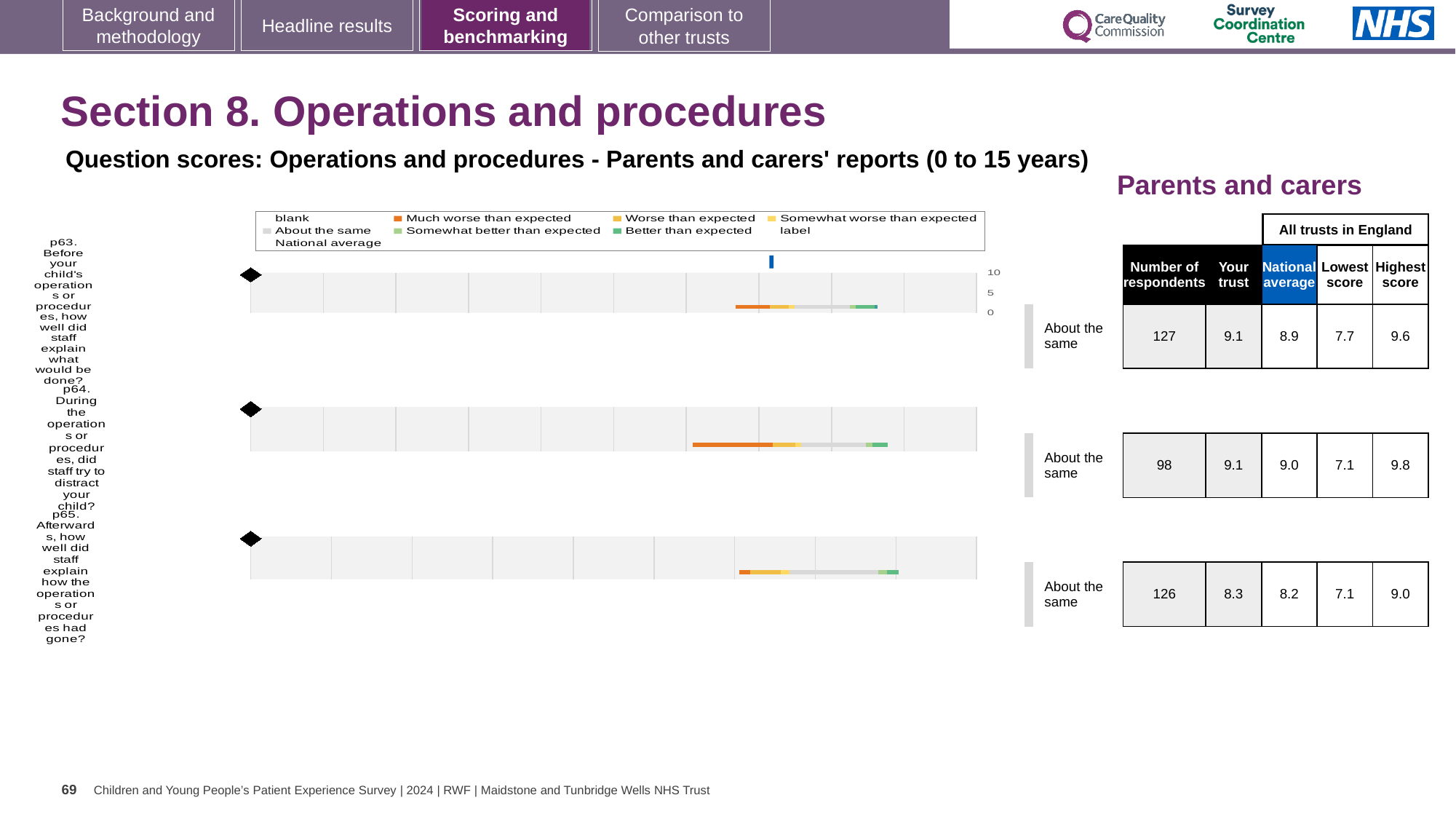
How many survey questions are plotted as bars on the slide? 3 What kind of chart is used to show the question scores for p63, p64 and p65? bar chart According to the legend, what does the blue vertical marker on the bars represent? National average How many respondents answered p65 (how well staff explained how the operation had gone)? 126 For p63, which is larger: the 'Your trust' score or the national average? Your trust What is the 'Your trust' score for p63 (how well staff explained what would be done before the operation)? 9.1 What benchmark category is shown next to each of the three question bars? About the same Which question has the lowest 'Your trust' score on the slide? p65 What is the difference between the highest score and the lowest score for p65? 1.9 What is the lowest score among all trusts in England for p63? 7.7 What is the highest score among all trusts in England for p64? 9.8 What is the national average score for p64 (did staff try to distract your child during the operation)? 9.0